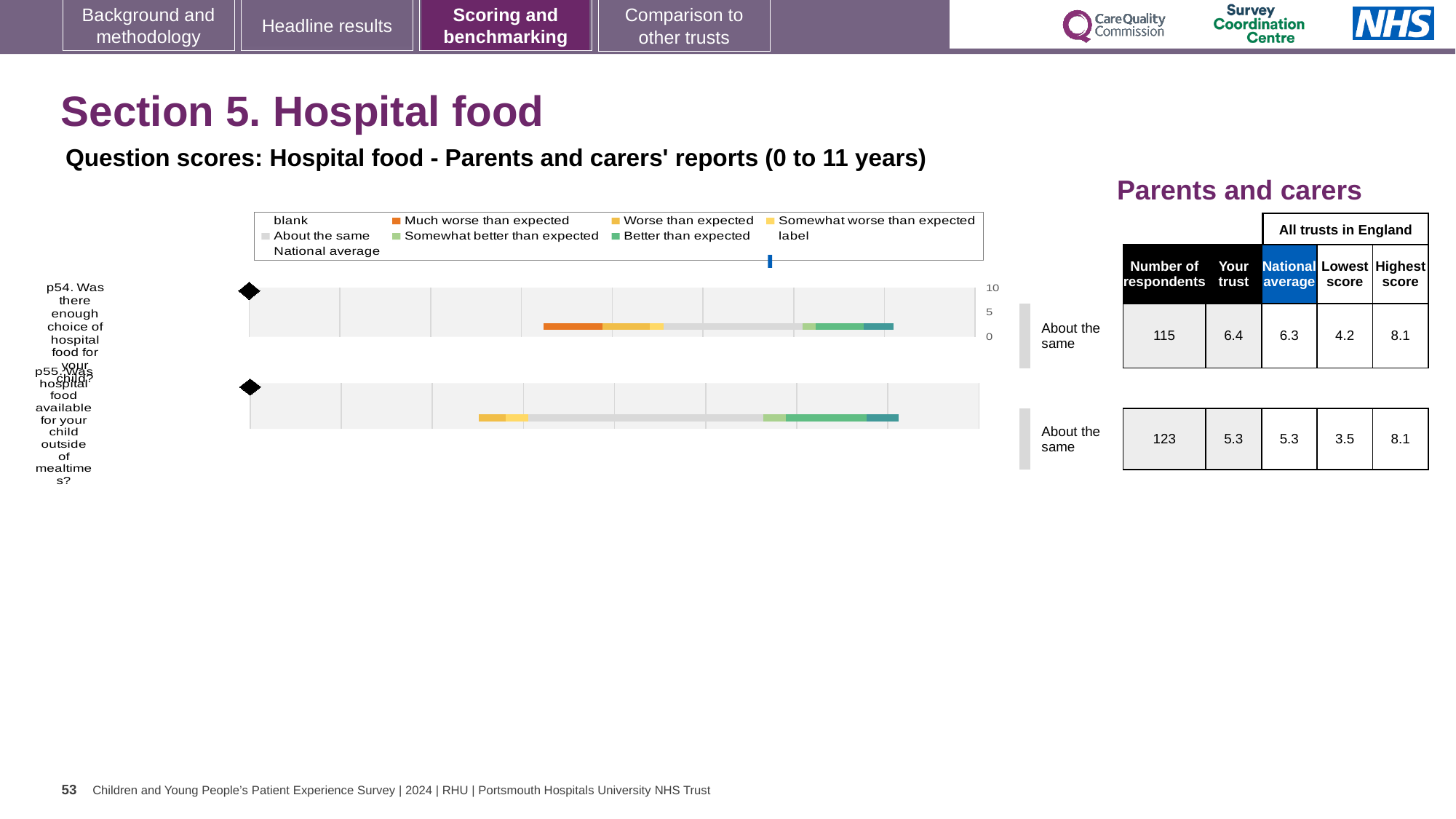
How many survey questions (bars) are plotted in the chart? 2 What kind of chart is shown on the slide? bar chart What is the national average score for question p55 in the table beside the chart? 5.3 What is the lowest score across all trusts in England for question p55? 3.5 What is the difference between the 'Your trust' score and the national average for question p54? 0.1 Which legend entry is shown with a dark blue marker? National average Which question has more respondents, p54 or p55? p55 Which colour in the legend represents 'Much worse than expected'? orange How many respondents answered question p54 according to the table beside the chart? 115 What benchmark category is given for both p54 and p55? About the same What is the 'Your trust' score for question p54 in the table beside the chart? 6.4 For question p54, is the 'Your trust' score or the national average score larger? Your trust